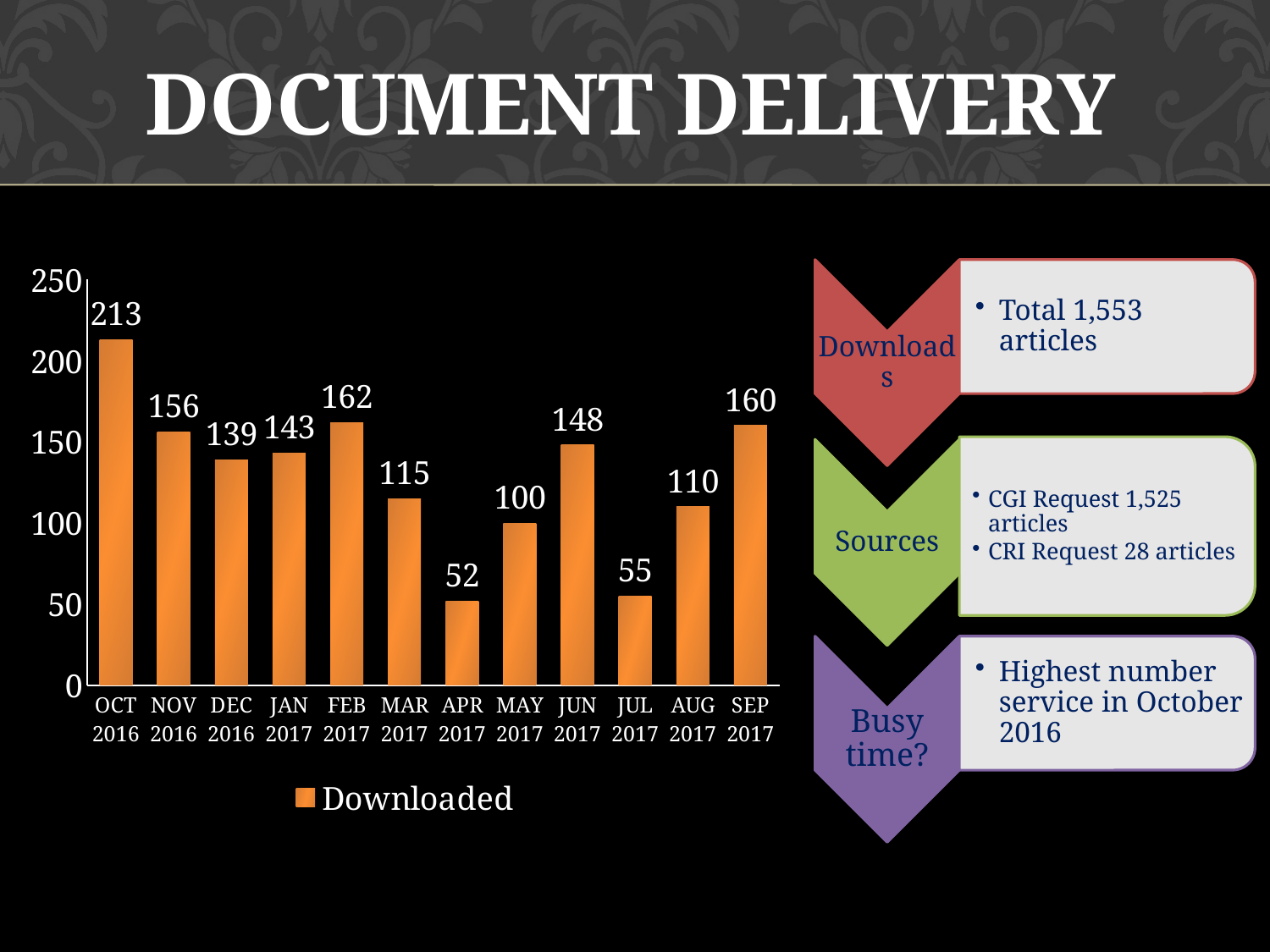
What is the value for APR 2017? 52 What is the difference between the values for JUN 2017 and JUL 2017? 93 What is the value for SEP 2017? 160 What is the value for OCT 2016? 213 What kind of chart is shown on the slide? bar chart Which month has the highest number of downloads? OCT 2016 Is the value for MAR 2017 greater or less than 100? greater Which is larger, the value for FEB 2017 or the value for SEP 2017? FEB 2017 Which month has the lowest number of downloads? APR 2017 What series name is listed in the chart legend? Downloaded What is the difference between the values for OCT 2016 and NOV 2016? 57 How many months are shown on the x axis? 12